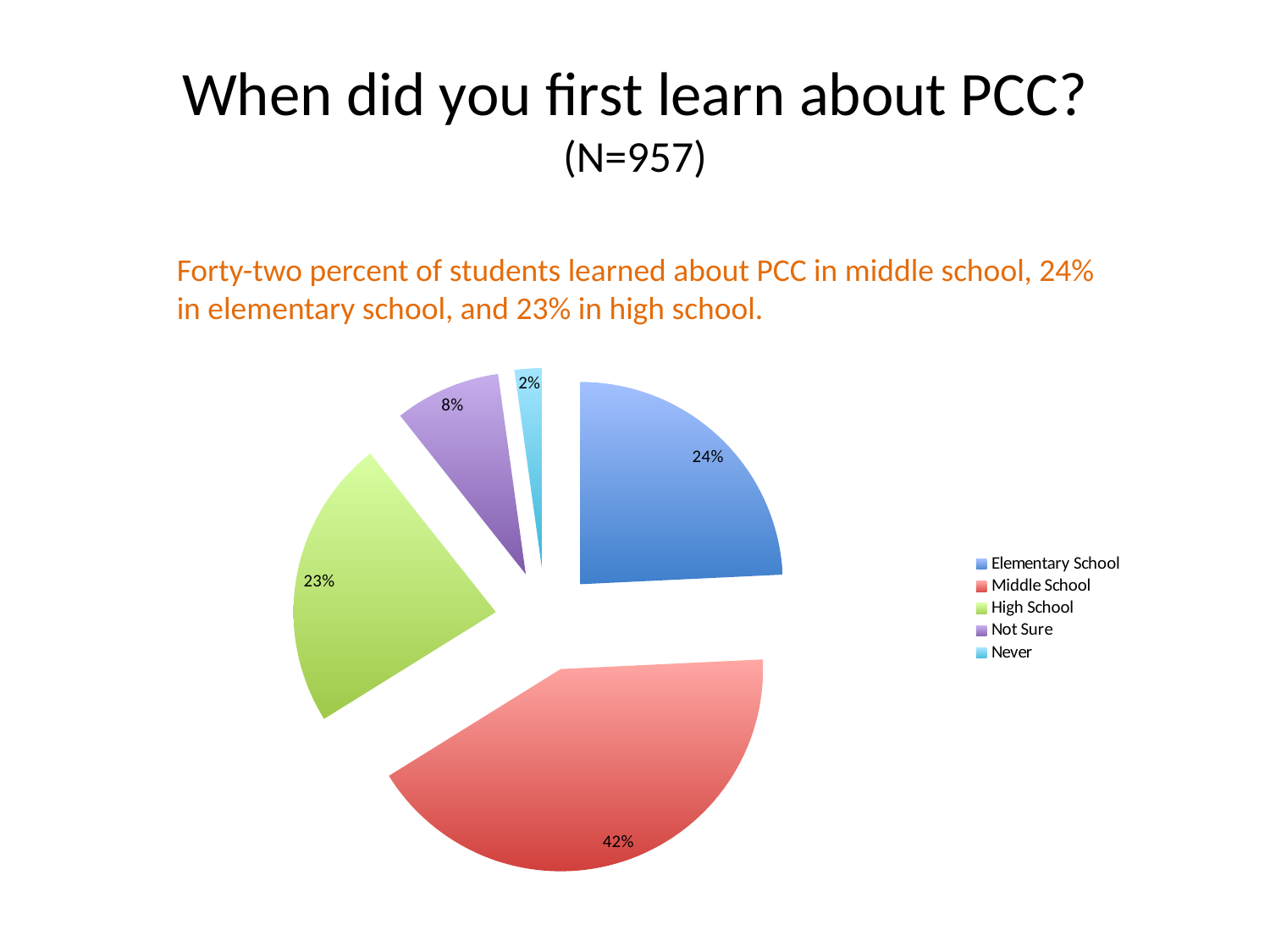
What type of chart is shown on the slide? pie chart What share of the pie does Not Sure represent? 8% What share of the pie does Middle School represent? 42% How many categories does the legend list? 5 What share of the pie does Never represent? 2% What is the difference in percentage points between Middle School and Elementary School? 18 Which category has the smallest slice of the pie? Never Which is larger, the share for Not Sure or the share for Never? Not Sure What colour is the Middle School slice? red Which category has the largest slice of the pie? Middle School